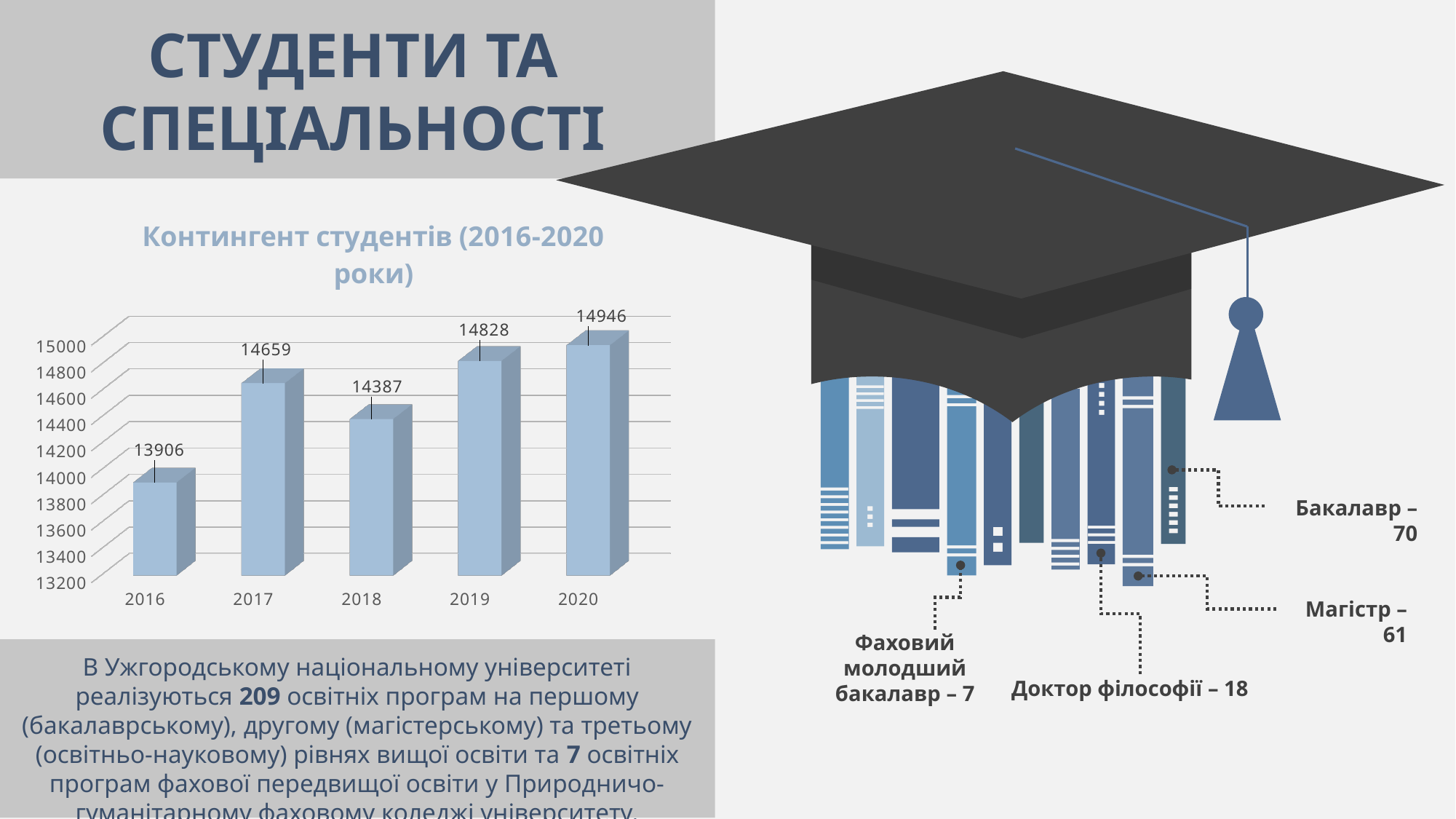
What is the title of the chart? Контингент студентів (2016-2020 роки) What is the difference between the values for 2017 and 2018? 272 What is the value for 2016 in the chart? 13906 Is the value for 2019 greater or less than 14600? greater How many years are shown on the x axis of the chart? 5 What is the value for 2018 in the chart? 14387 Which year has the highest value in the chart? 2020 What is the value for 2020 in the chart? 14946 Which year has the lowest value in the chart? 2016 What kind of chart is shown on the slide? bar chart Which is larger, the value for 2017 or the value for 2018? 2017 What is the difference between the values for 2020 and 2016? 1040